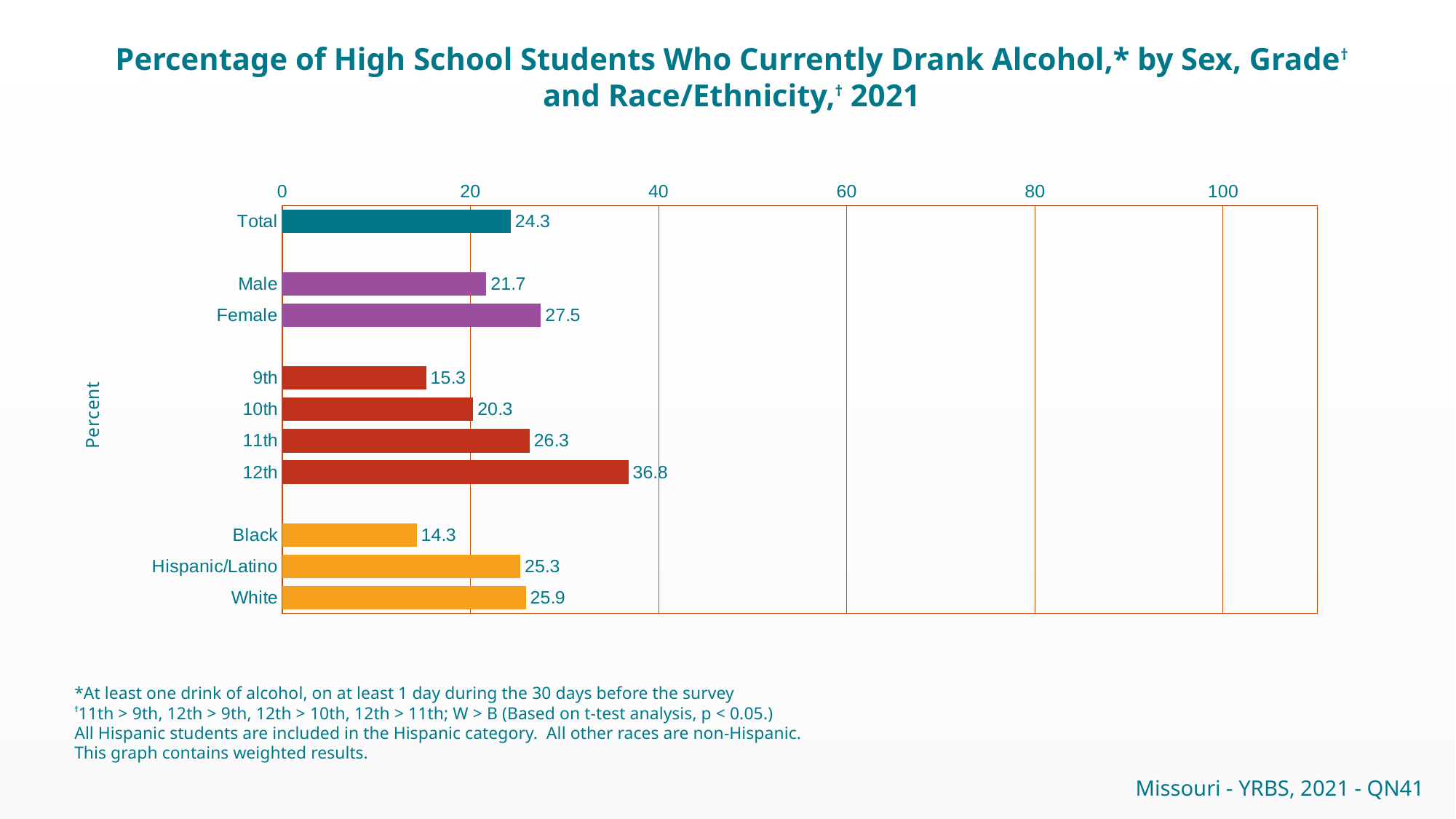
What is the value for Female? 27.5 What is the difference between the 12th and 9th grade values? 21.5 Do the values rise or fall from 9th grade to 12th grade? rise What is the value for Hispanic/Latino? 25.3 Which category has the lowest value? Black Which is larger, the value for White or the value for Black? White What is the value for Total? 24.3 Which category has the highest value? 12th How many categories are shown in the chart? 10 What is the value for 12th grade? 36.8 What is the difference between the Female and Male values? 5.8 What kind of chart is shown on the slide? bar chart